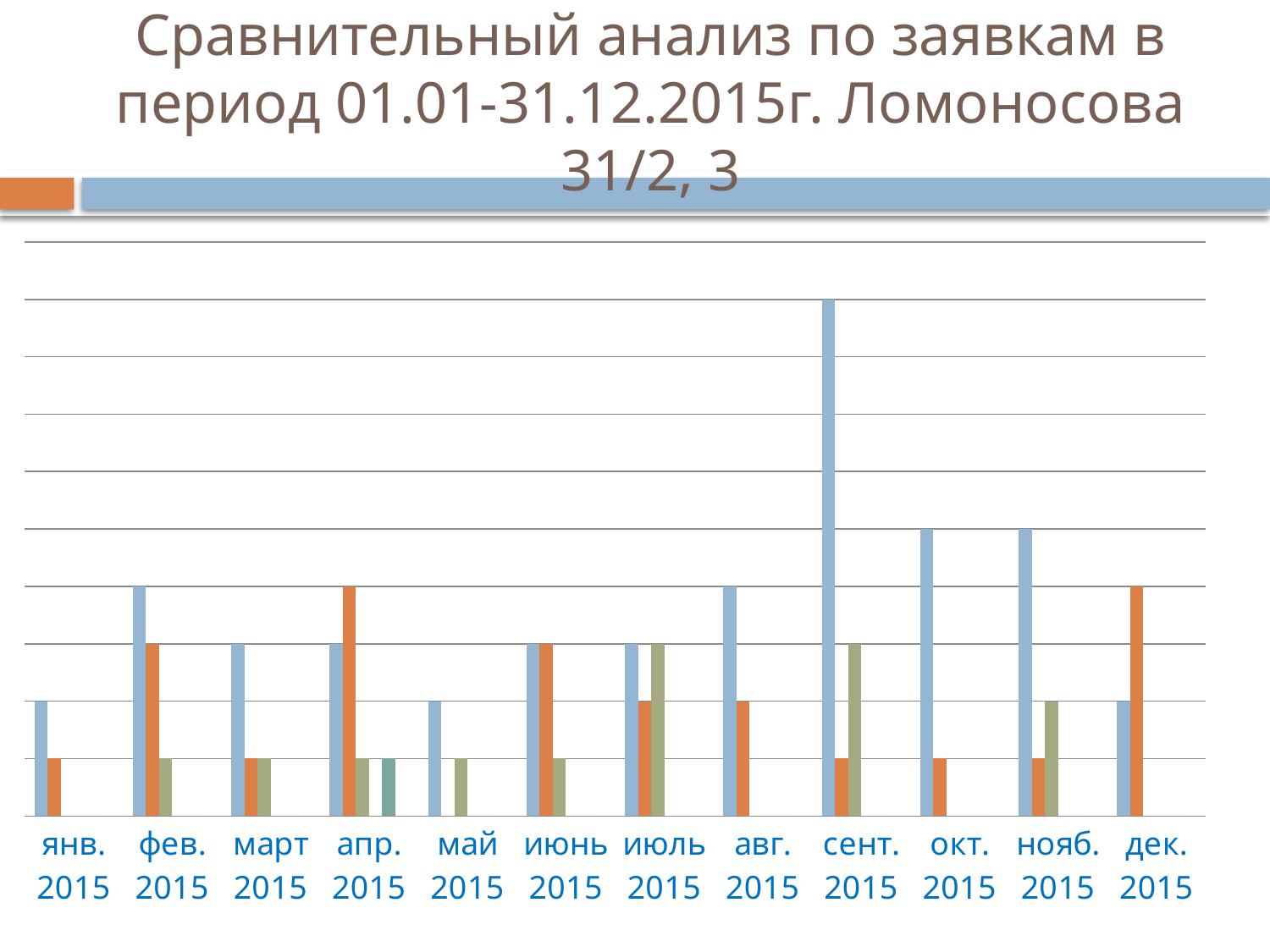
What kind of chart is shown on the slide? bar chart In which month is the tallest bar of the chart? сент. 2015 Is the orange bar for апр. 2015 taller or shorter than the orange bar for фев. 2015? taller How many months (categories) are shown along the x axis? 12 Which month has the highest blue bar? сент. 2015 Is the blue bar for сент. 2015 taller or shorter than the blue bar for окт. 2015? taller Is the blue bar for авг. 2015 taller or shorter than the blue bar for июль 2015? taller What colour is the tallest bar on the chart? blue Which month has the most bars (the most series with a visible bar)? апр. 2015